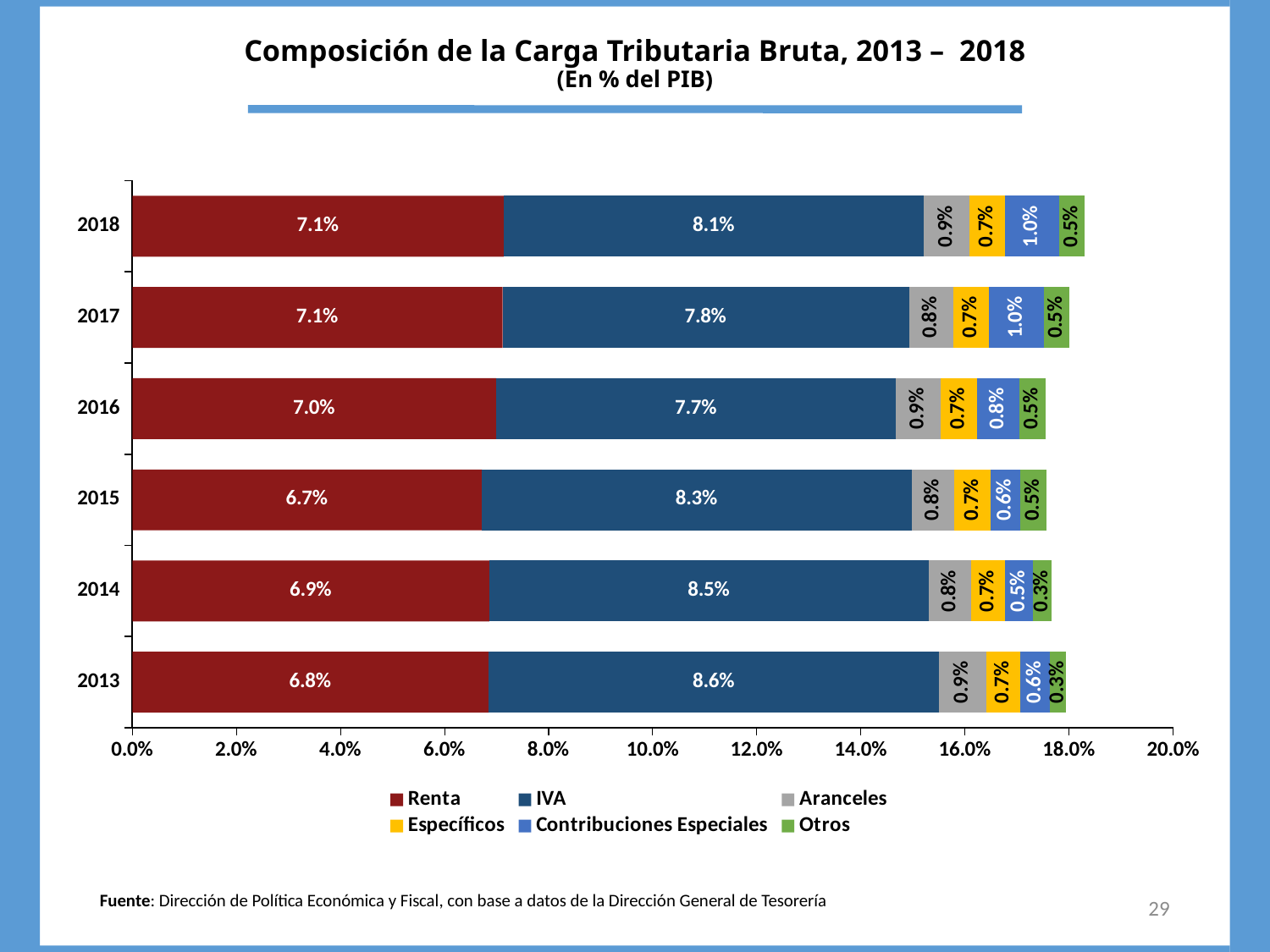
What kind of chart is shown on the slide? Stacked bar chart What is the total of the stacked bar for 2018? 18.3% What is the value of Renta for 2018? 7.1% Which year has the highest IVA value? 2013 Which is larger, the Renta value for 2014 or the Renta value for 2015? 2014 Which year has the lowest Renta value? 2015 What is the value of IVA for 2013? 8.6% How many years are shown on the chart? 6 What is the difference between the IVA value for 2013 and the IVA value for 2018? 0.5% What is the value of Contribuciones Especiales for 2016? 0.8% What is the title of the chart? Composición de la Carga Tributaria Bruta, 2013 – 2018 (En % del PIB) How many series does the legend list? 6